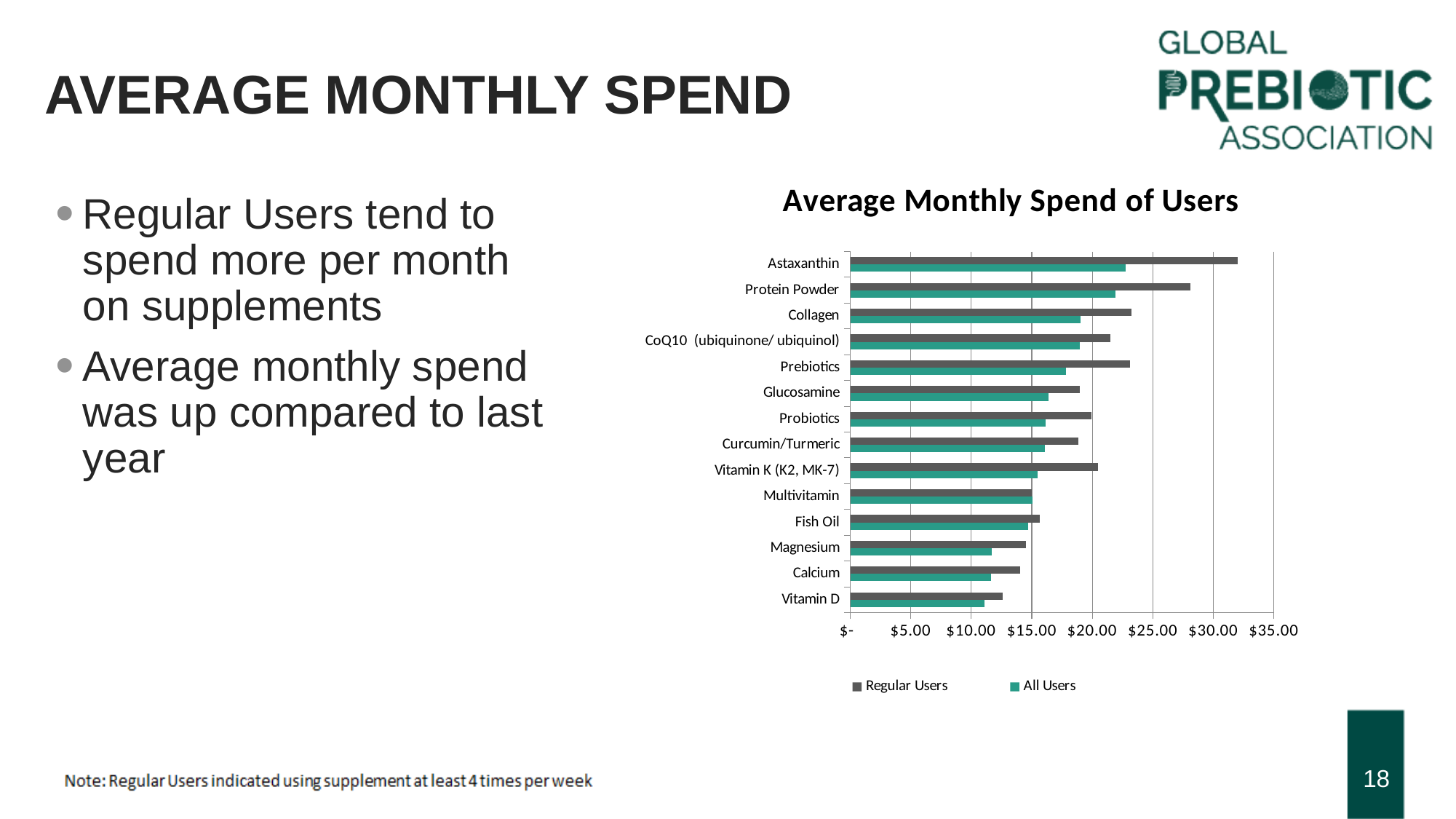
Which supplement has the highest average monthly spend for Regular Users? Astaxanthin Is the All Users value for Collagen greater or less than $20.00? less How many series does the legend list? 2 What is the title of the chart? Average Monthly Spend of Users Which is larger for Regular Users: the value for Prebiotics or the value for Probiotics? Prebiotics Is the Regular Users value for Astaxanthin greater or less than $30.00? greater Which series is shown in green on the chart? All Users How many supplement categories are shown on the chart? 14 Is the Regular Users value for Protein Powder greater or less than $25.00? greater Which supplement has the lowest average monthly spend for Regular Users? Vitamin D What type of chart is shown on the slide? Bar chart